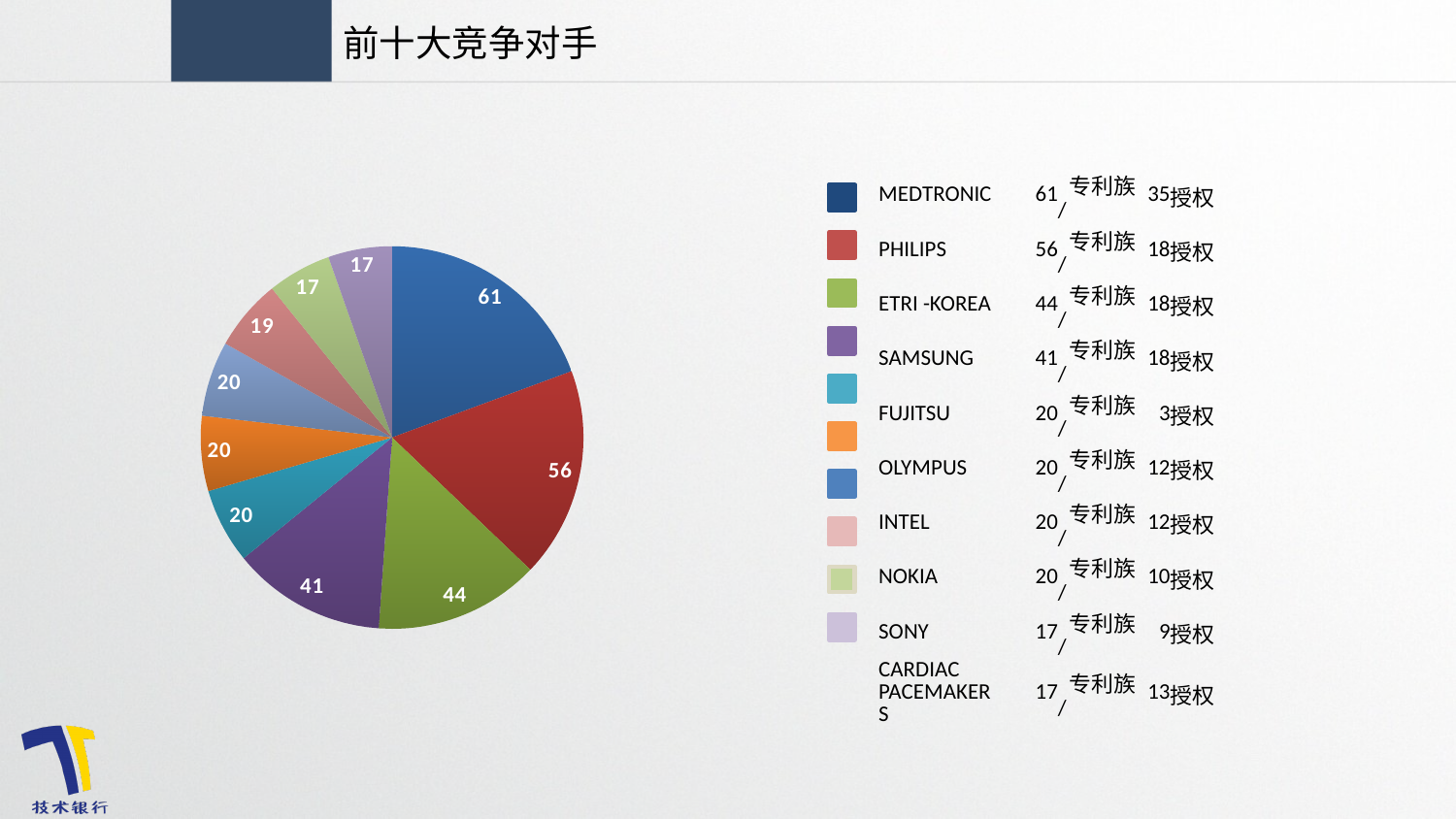
Which competitor has the largest slice in the pie chart? MEDTRONIC What is the smallest value labelled on the pie chart? 17 What is the value shown for SONY in the pie chart? 17 How many slices does the pie chart have? 10 What kind of chart is shown on the slide? pie chart What is the value shown for SAMSUNG in the pie chart? 41 What is the difference between the values for PHILIPS and ETRI -KOREA? 12 What is the value shown for PHILIPS in the pie chart? 56 What is the value shown for ETRI -KOREA in the pie chart? 44 What is the difference between the values for MEDTRONIC and PHILIPS? 5 Which has a larger value, ETRI -KOREA or SAMSUNG? ETRI -KOREA What is the title of the slide? 前十大竞争对手